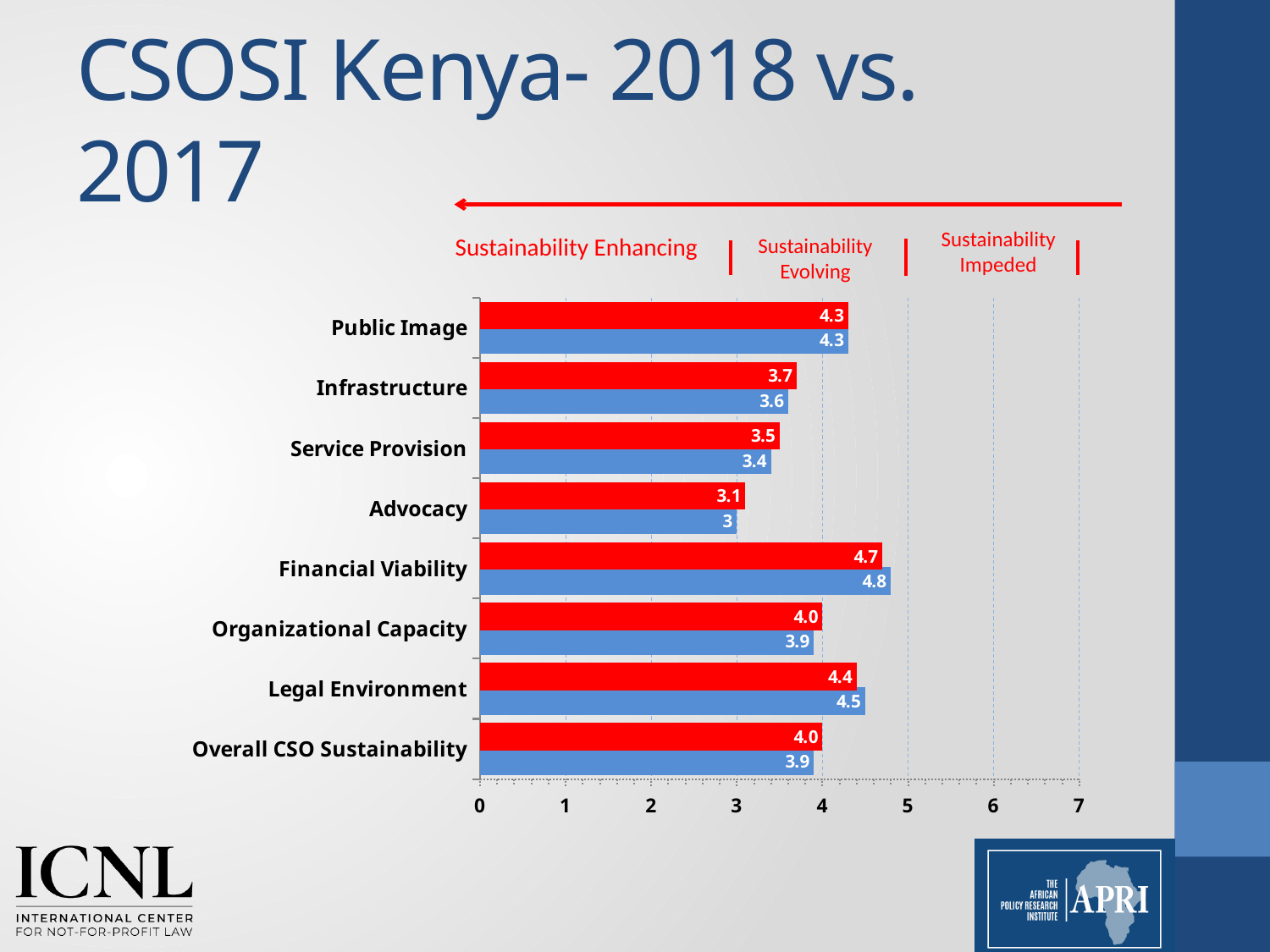
How many categories are plotted on the chart? 8 What is the difference between the blue bar and the red bar for Financial Viability? 0.1 What is the value of the red bar for Public Image? 4.3 What is the value of the blue bar for Legal Environment? 4.5 What is the value of the blue bar for Advocacy? 3 Is the value of the red bar for Infrastructure greater or less than 4? less What is the value of the red bar for Overall CSO Sustainability? 4.0 Which category has the lowest blue bar value? Advocacy Which category has the highest red bar value? Financial Viability What is the title of the slide containing the chart? CSOSI Kenya- 2018 vs. 2017 What type of chart is shown on the slide? bar chart Which is larger: the red bar for Financial Viability or the red bar for Legal Environment? Financial Viability